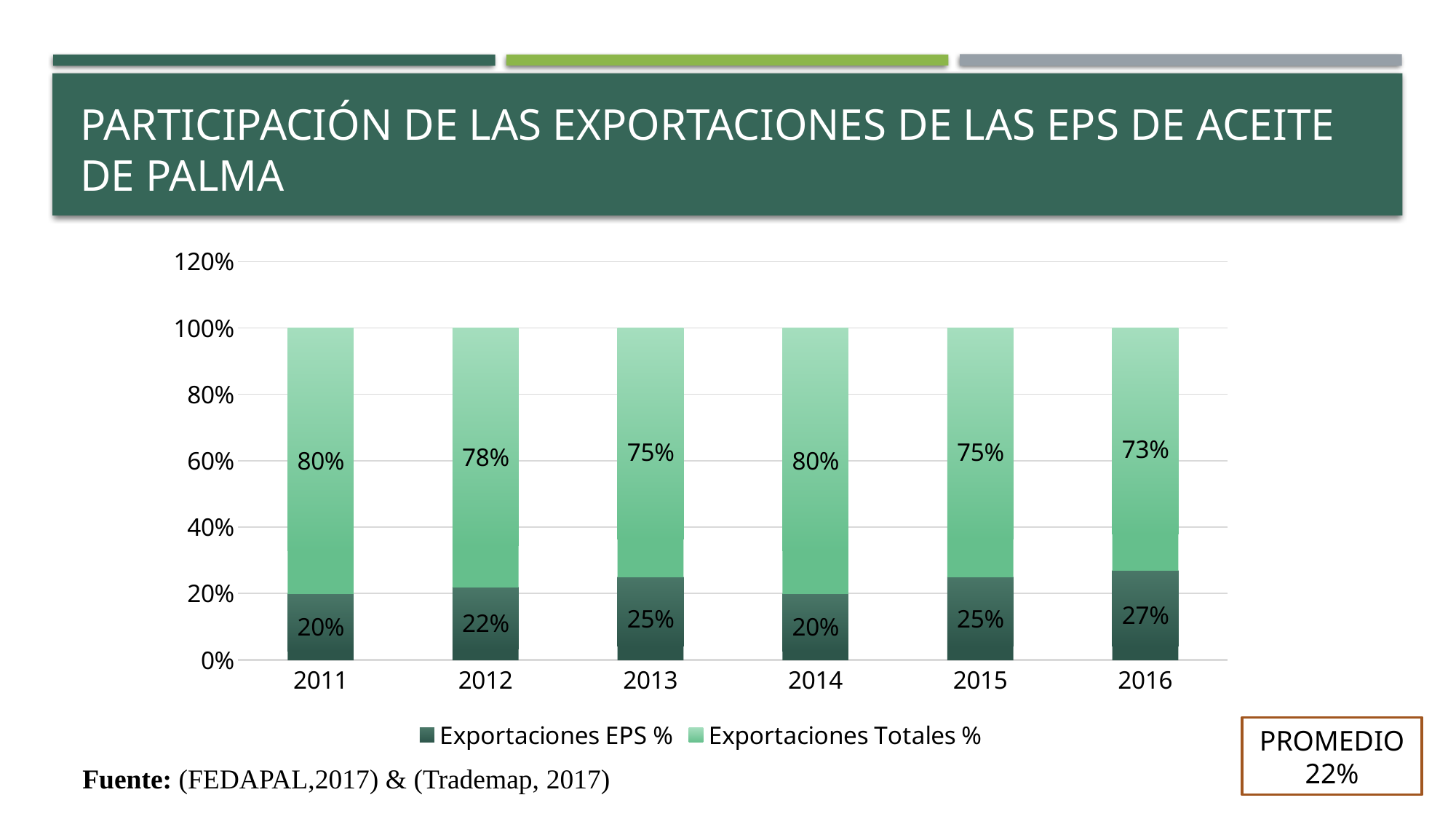
What is the difference between the Exportaciones EPS % values for 2016 and 2011? 7% What is the total of the stacked bar for 2014? 100% Which year has the lowest Exportaciones Totales % value? 2016 What kind of chart is shown on the slide? Stacked bar chart Which year has the highest Exportaciones EPS % value? 2016 What is the value of Exportaciones Totales % for 2012? 78% How many series does the legend list? 2 How many years are shown on the x axis? 6 Which is larger, the Exportaciones EPS % value for 2012 or for 2015? 2015 What is the value of Exportaciones EPS % for 2013? 25% What value is shown in the PROMEDIO box on the slide? 22% What is the value of Exportaciones EPS % for 2016? 27%